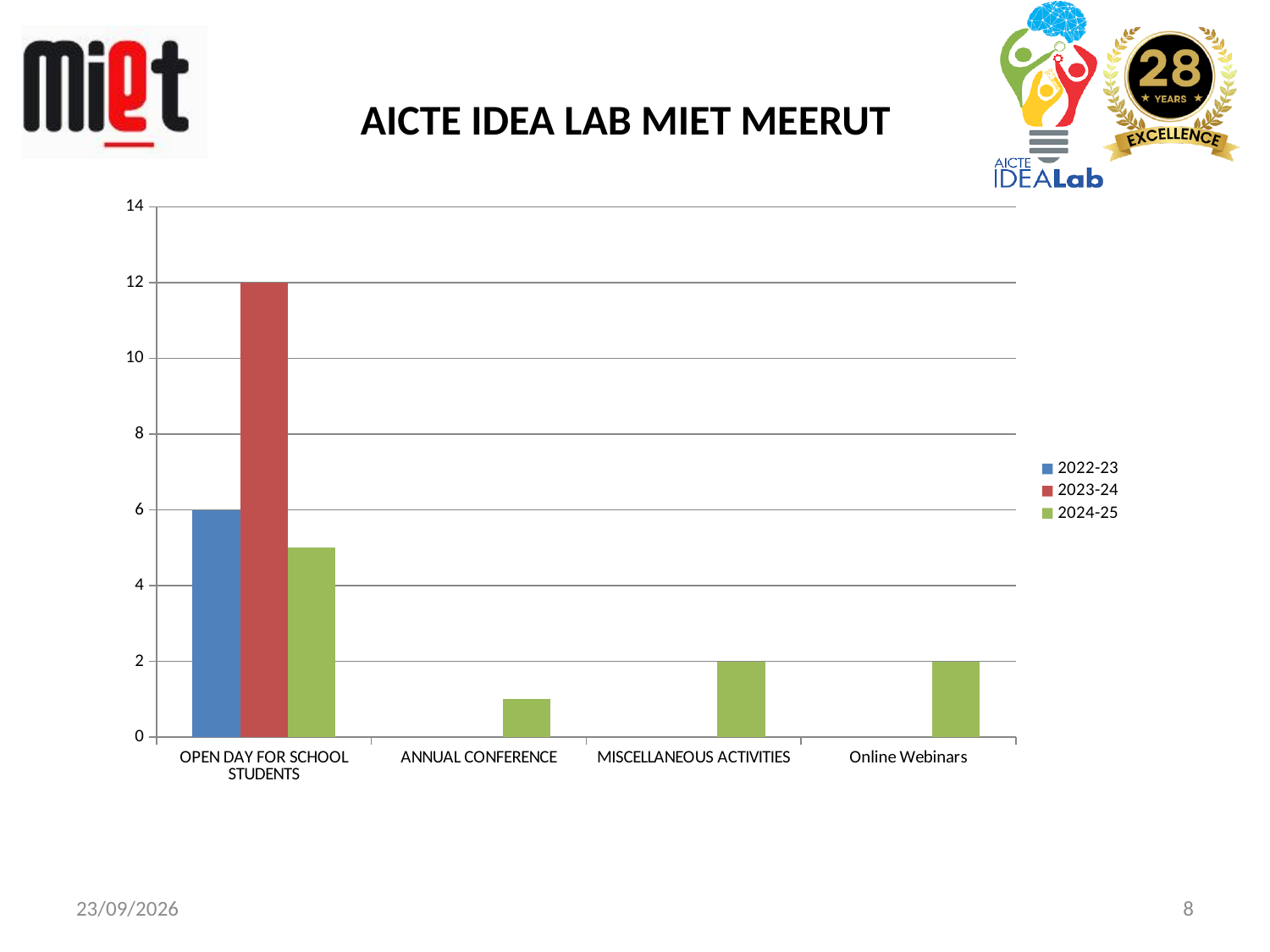
What is the value for 2023-24 in the OPEN DAY FOR SCHOOL STUDENTS category? 12 How many series does the legend list? 3 Is the value for 2024-25 in the OPEN DAY FOR SCHOOL STUDENTS category greater or less than 4? greater What is the difference between the 2023-24 and 2022-23 values for OPEN DAY FOR SCHOOL STUDENTS? 6 How many categories are shown on the x axis? 4 Which series has the highest value in the OPEN DAY FOR SCHOOL STUDENTS category? 2023-24 What is the value for 2024-25 in the MISCELLANEOUS ACTIVITIES category? 2 What is the value for 2024-25 in the Online Webinars category? 2 What is the value for 2022-23 in the OPEN DAY FOR SCHOOL STUDENTS category? 6 What is the title of the chart? AICTE IDEA LAB MIET MEERUT Is the value for 2024-25 in the ANNUAL CONFERENCE category greater or less than 2? less What kind of chart is shown on the slide? bar chart